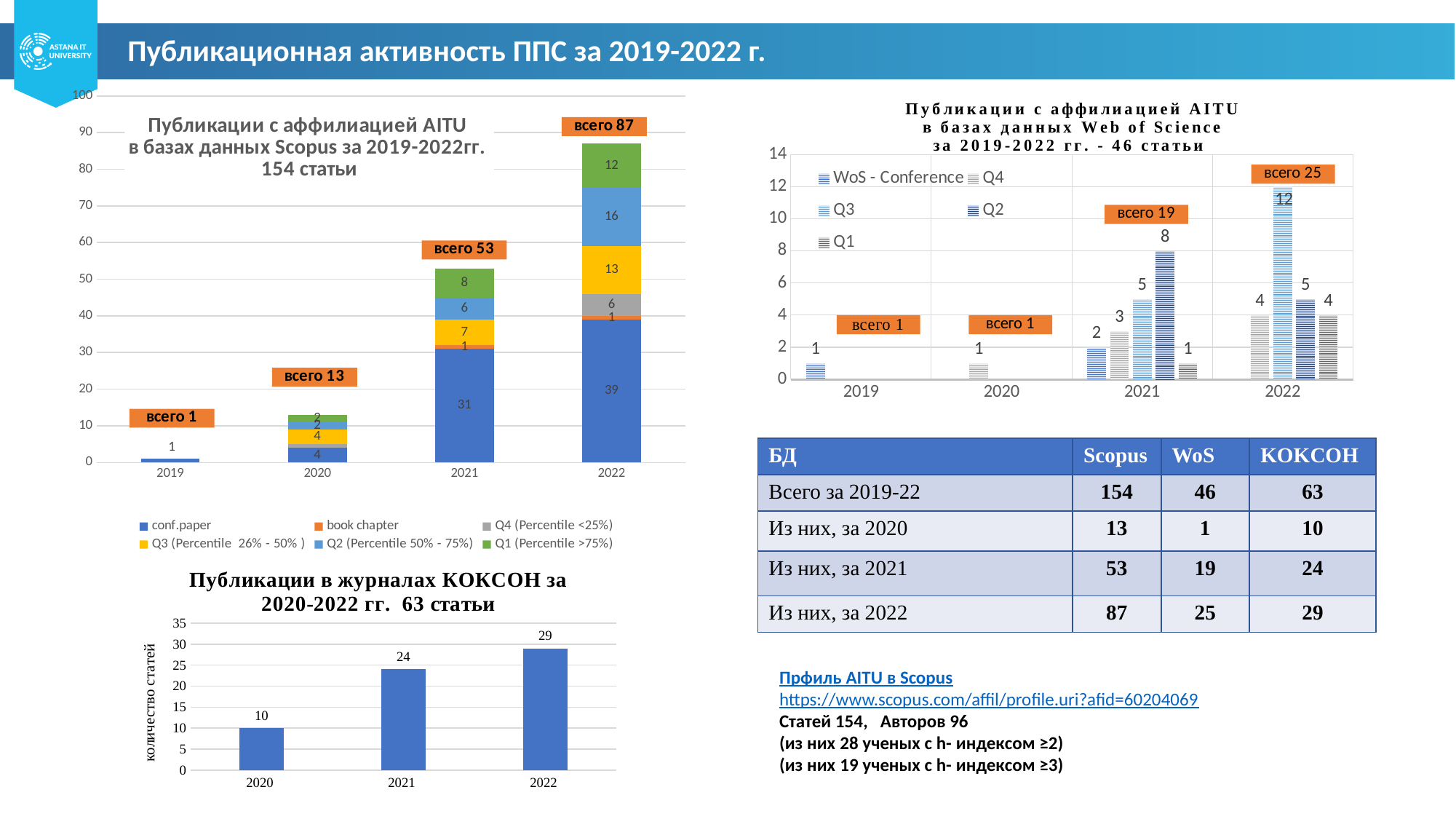
In the Web of Science chart (top right), what is the Q2 value for 2021? 8 In the Web of Science chart (top right), what is the Q3 value for 2022? 12 In the Scopus chart (top left), what is the total (всего) for 2021? всего 53 In the КОКСОН chart (bottom left), do the values rise or fall from 2020 to 2022? rise In the Scopus chart (top left), how many series does the legend list? 6 In the Scopus chart (top left), which year has the highest total? 2022 In the Web of Science chart (top right), how many series does the legend list? 5 In the КОКСОН chart (bottom left), what is the value for 2021? 24 In the Scopus chart (top left), what is the difference between the conf.paper values for 2022 and 2021? 8 In the Scopus chart (top left), what is the Q2 (Percentile 50% - 75%) value for 2022? 16 What kind of chart is the КОКСОН chart (bottom left)? bar chart In the Scopus chart (top left), what is the conf.paper value for 2022? 39